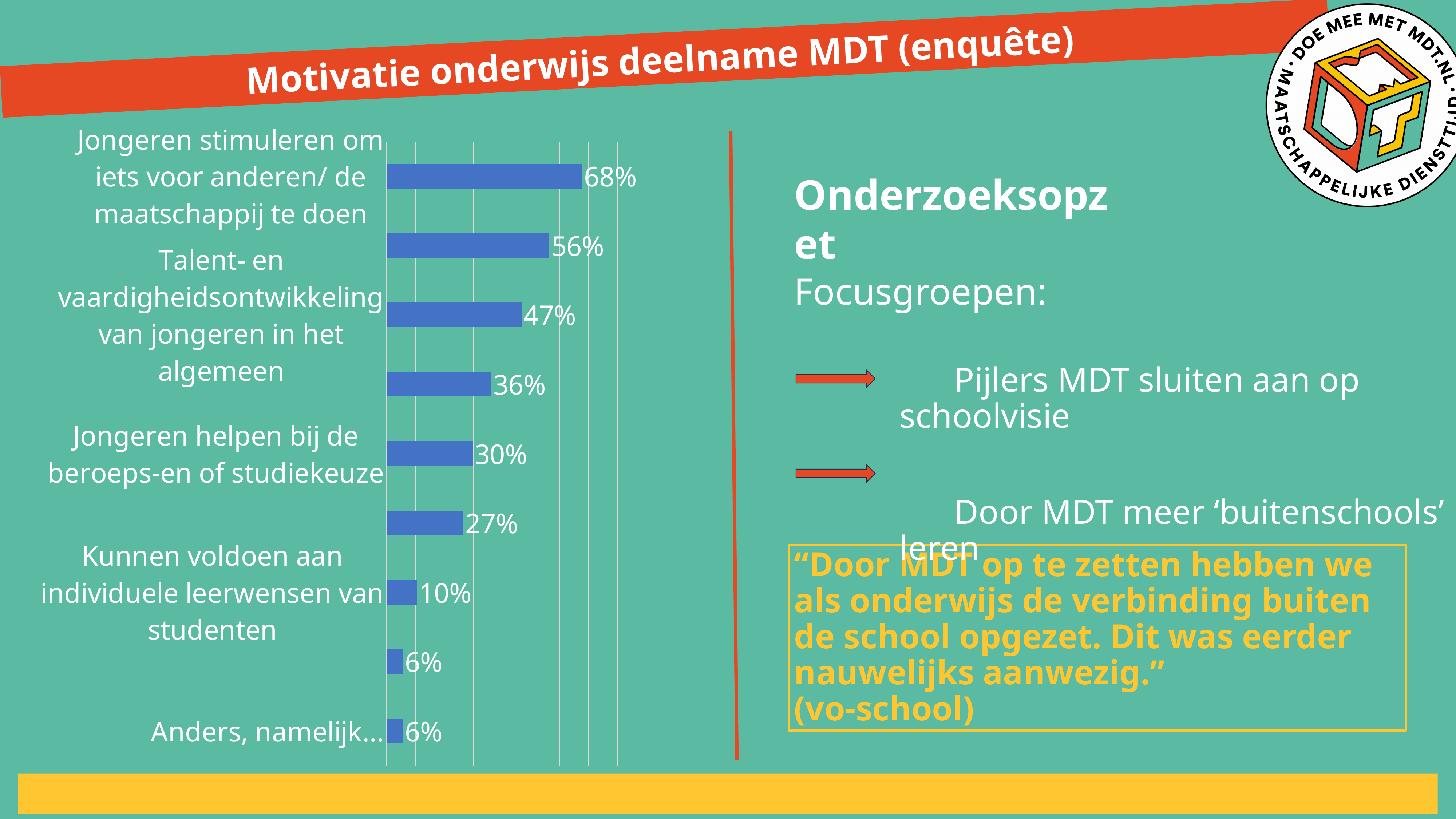
What is the value of the top bar, labelled 'Jongeren stimuleren om iets voor anderen/ de maatschappij te doen'? 68% What type of chart is shown on the slide? bar chart How many bars are plotted in the chart? 9 What is the value of the longest bar in the chart? 68% What is the value shown for 'Anders, namelijk...'? 6% What is the difference between the top bar (68%) and the bar for 'Anders, namelijk...' (6%)? 62% What colour are the bars in the chart? blue Do the bar values increase or decrease from the top of the chart to the bottom? decrease What is the smallest value shown as a data label in the chart? 6% What is the title shown in the banner above the chart? Motivatie onderwijs deelname MDT (enquête) What is the value of the second-longest bar in the chart? 56% Which is larger: the top bar or the bar for 'Anders, namelijk...'? the top bar